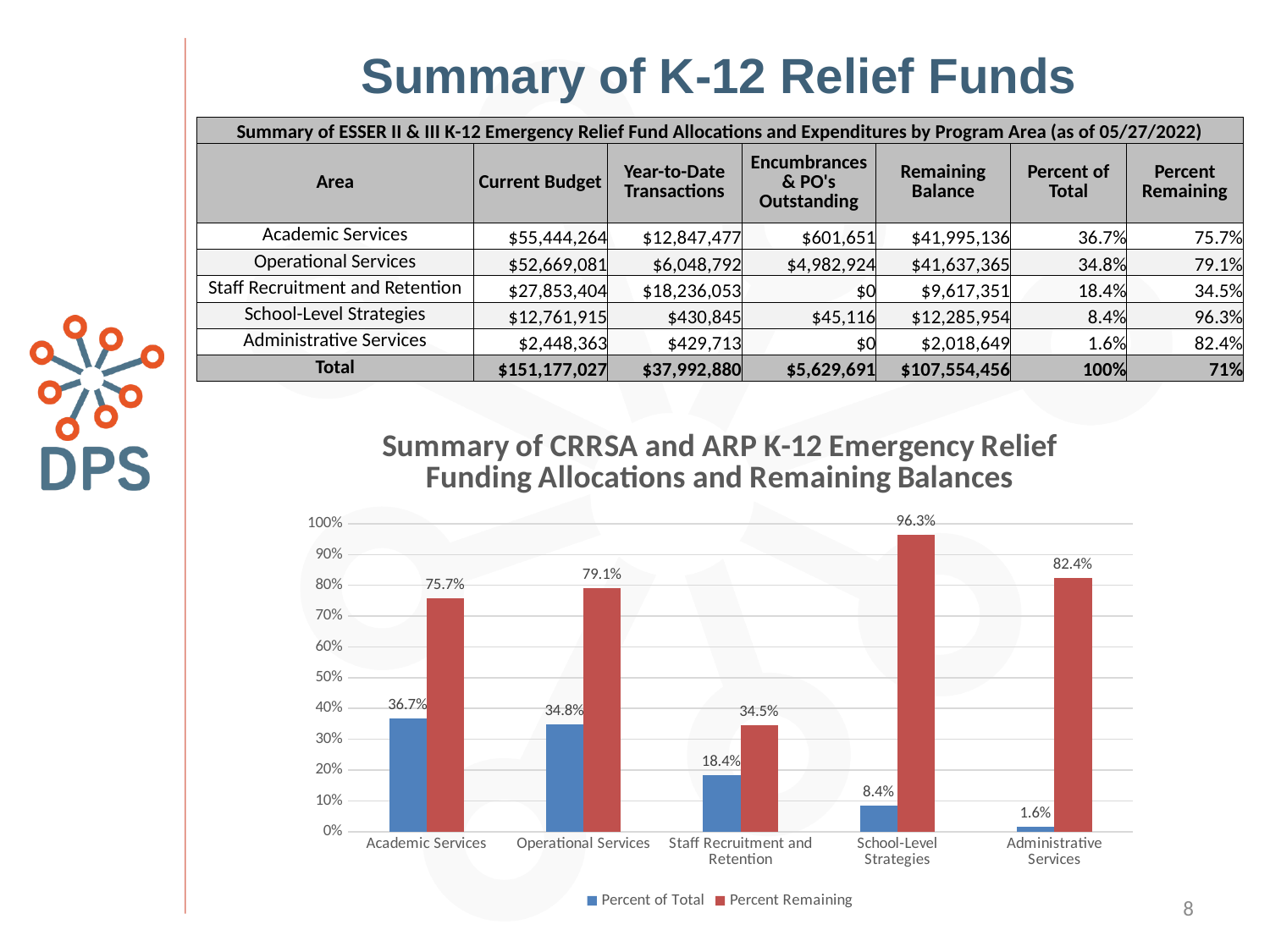
Which category has the lowest Percent of Total in the chart? Administrative Services What is the Percent Remaining for School-Level Strategies in the chart? 96.3% What colour are the Percent Remaining bars in the chart? Red Which category has the highest Percent Remaining in the chart? School-Level Strategies Is the Percent Remaining for Administrative Services greater or less than 80%? greater Which is larger for Staff Recruitment and Retention: Percent of Total or Percent Remaining? Percent Remaining What is the difference between the Percent Remaining and the Percent of Total for Academic Services? 39.0% What kind of chart is shown on the slide? Bar chart Does the Percent of Total series rise or fall from Academic Services to Administrative Services? Fall How many series does the chart legend list? 2 What is the Percent of Total for Operational Services in the chart? 34.8% How many categories are shown on the x axis of the chart? 5